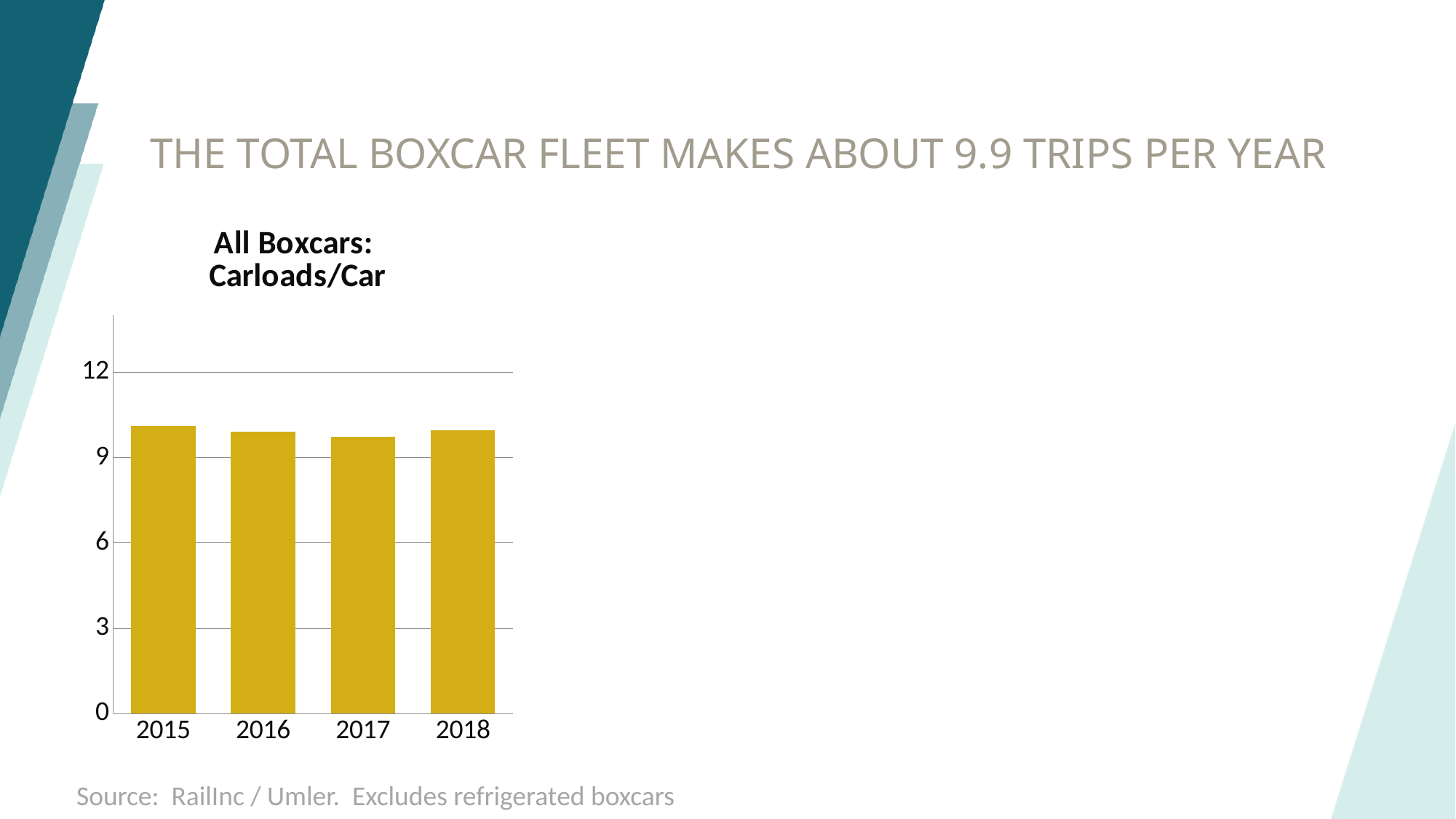
Is the value for 2016 greater or less than 12? less What is the title of the chart? All Boxcars: Carloads/Car Is the value for 2017 greater or less than 12? less What kind of chart is shown on the slide? bar chart Is the value for 2015 greater or less than 9? greater Which is larger, the value for 2015 or the value for 2017? 2015 How many years are shown on the x axis of the chart? 4 What is the first year shown on the x axis? 2015 What is the highest value labelled on the y axis? 12